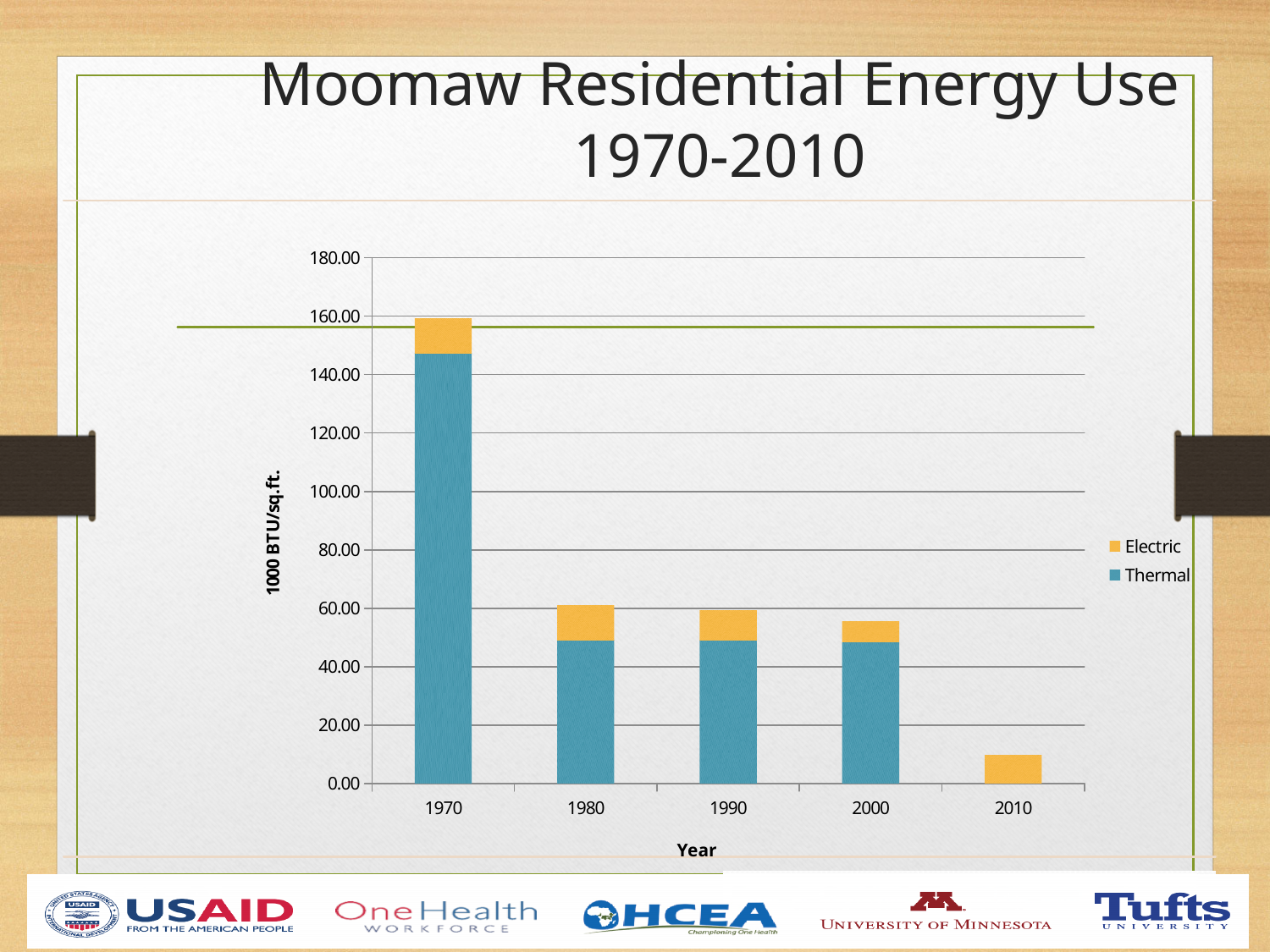
Do the total bar heights rise or fall from 1970 to 2010? Fall How many series does the chart's legend list? 2 What kind of chart is shown on the slide? Stacked bar chart Which year has the larger total bar, 1970 or 2000? 1970 Which year has the tallest bar in the chart? 1970 Is the total value for 1970 greater or less than 140? greater Is the total value for 2000 greater or less than 60? less Which series is shown in blue in the chart? Thermal What is the title of the chart's vertical axis? 1000 BTU/sq.ft. How many years are shown on the x axis of the chart? 5 Is the total value for 2010 greater or less than 20? less Which year has the shortest bar in the chart? 2010